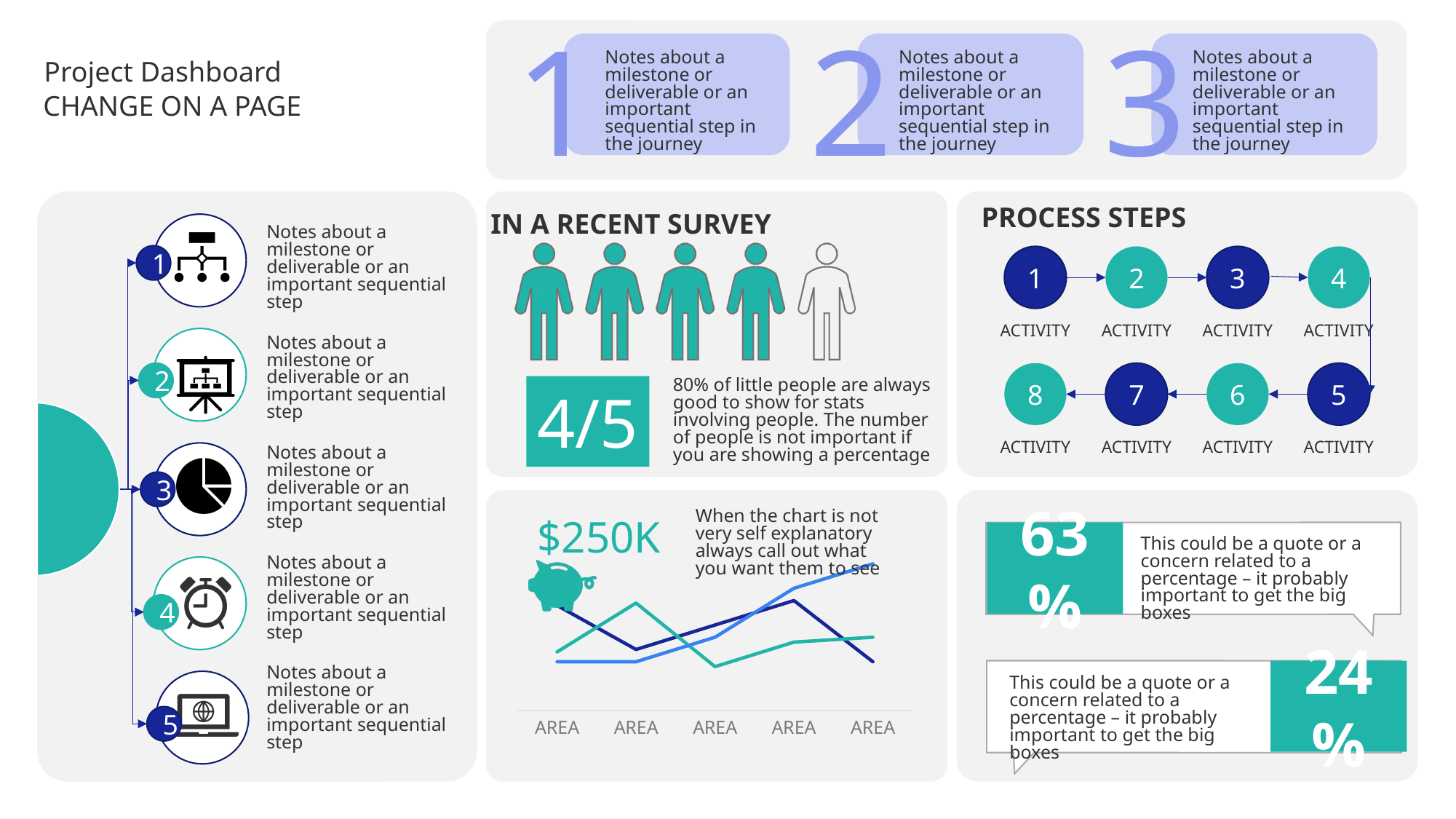
In the line chart, which line is highest at the leftmost AREA point? the dark blue line In the line chart, which line is highest at the rightmost AREA point? the light blue line In the line chart, does the light blue line rise or fall overall from left to right? rise In the line chart, which line is lowest at the rightmost AREA point? the dark blue line What kind of chart is shown in the bottom-middle panel with the AREA labels? line chart How many lines are plotted in the line chart? 3 What label is repeated for each category on the x axis of the line chart? AREA What value is called out in large text above the line chart next to the piggy bank icon? $250K How many categories are labelled along the x axis of the line chart? 5